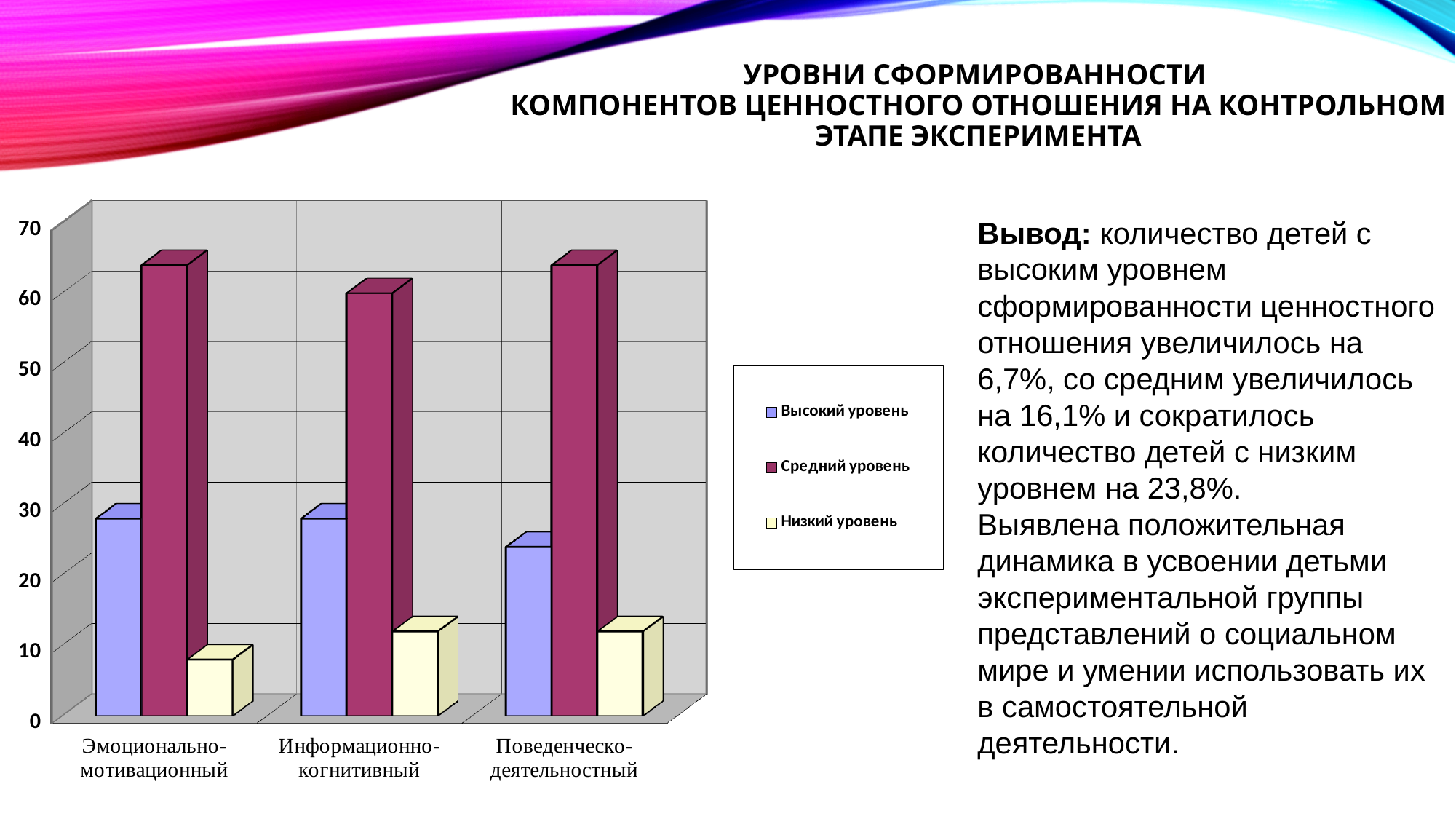
What is the first entry listed in the chart legend? Высокий уровень Which series has the lowest value in the Поведенческо-деятельностный category? Низкий уровень How many series does the chart legend list? 3 Is the value of Высокий уровень for Поведенческо-деятельностный greater or less than 30? less Is the value of Средний уровень for Информационно-когнитивный greater or less than 50? greater Which series has the highest value in the Эмоционально-мотивационный category? Средний уровень Which series is shown in the legend with a yellow (light) colour? Низкий уровень How many categories are shown on the x axis of the chart? 3 In the Информационно-когнитивный category, which is larger: Высокий уровень or Низкий уровень? Высокий уровень What kind of chart is shown on the slide? bar chart Is the value of Средний уровень for Эмоционально-мотивационный greater or less than 50? greater